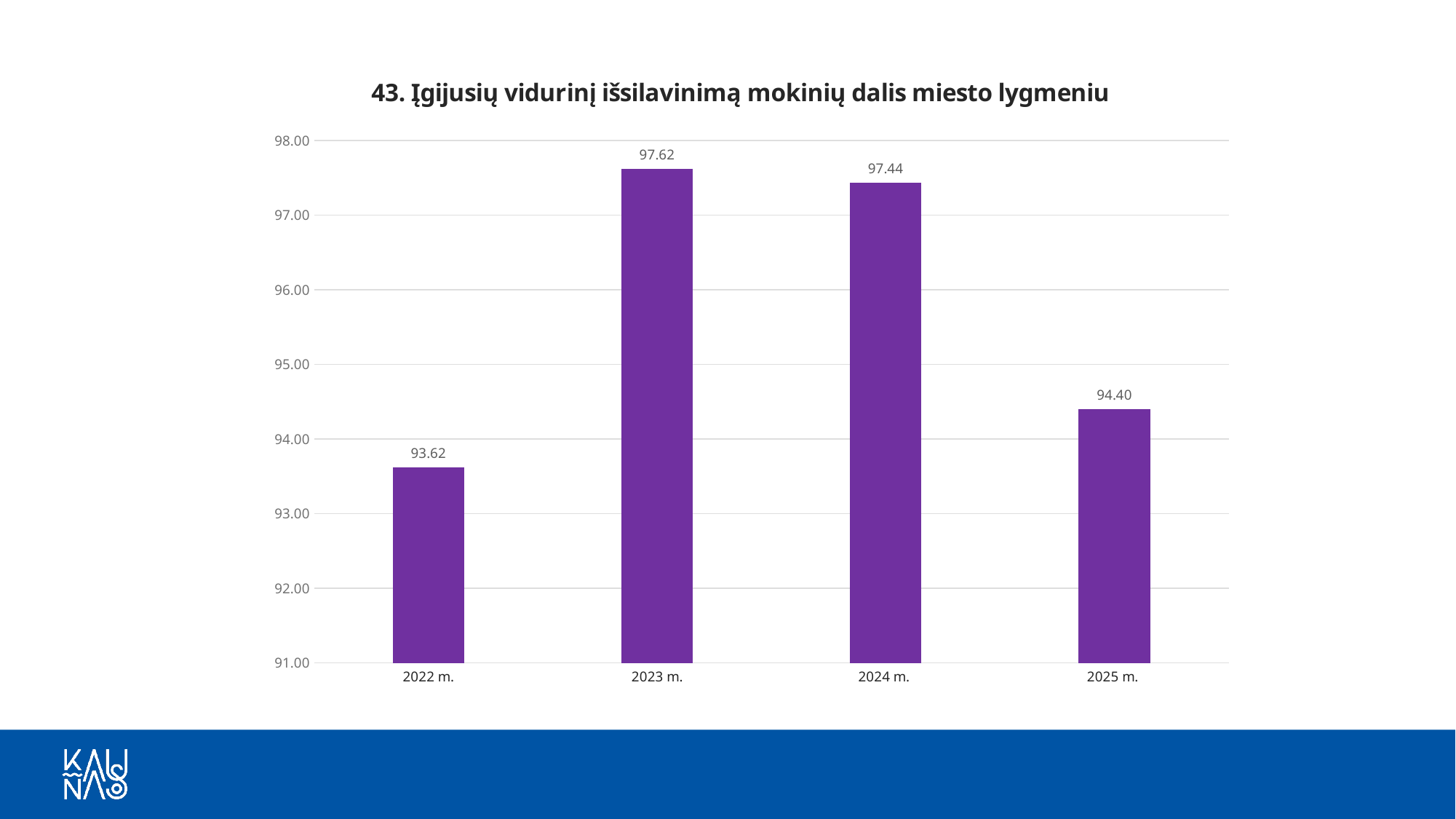
Which is larger, the value for 2022 m. or the value for 2025 m.? 2025 m. How many years are shown on the x axis? 4 Which year has the lowest value? 2022 m. What is the difference between the values for 2024 m. and 2025 m.? 3.04 What is the difference between the values for 2023 m. and 2022 m.? 4.00 What is the value for 2023 m.? 97.62 What is the value for 2025 m.? 94.40 Which year has the highest value? 2023 m. What is the value for 2022 m.? 93.62 What kind of chart is this? Bar chart What is the value for 2024 m.? 97.44 What is the title of the chart? 43. Įgijusių vidurinį išsilavinimą mokinių dalis miesto lygmeniu